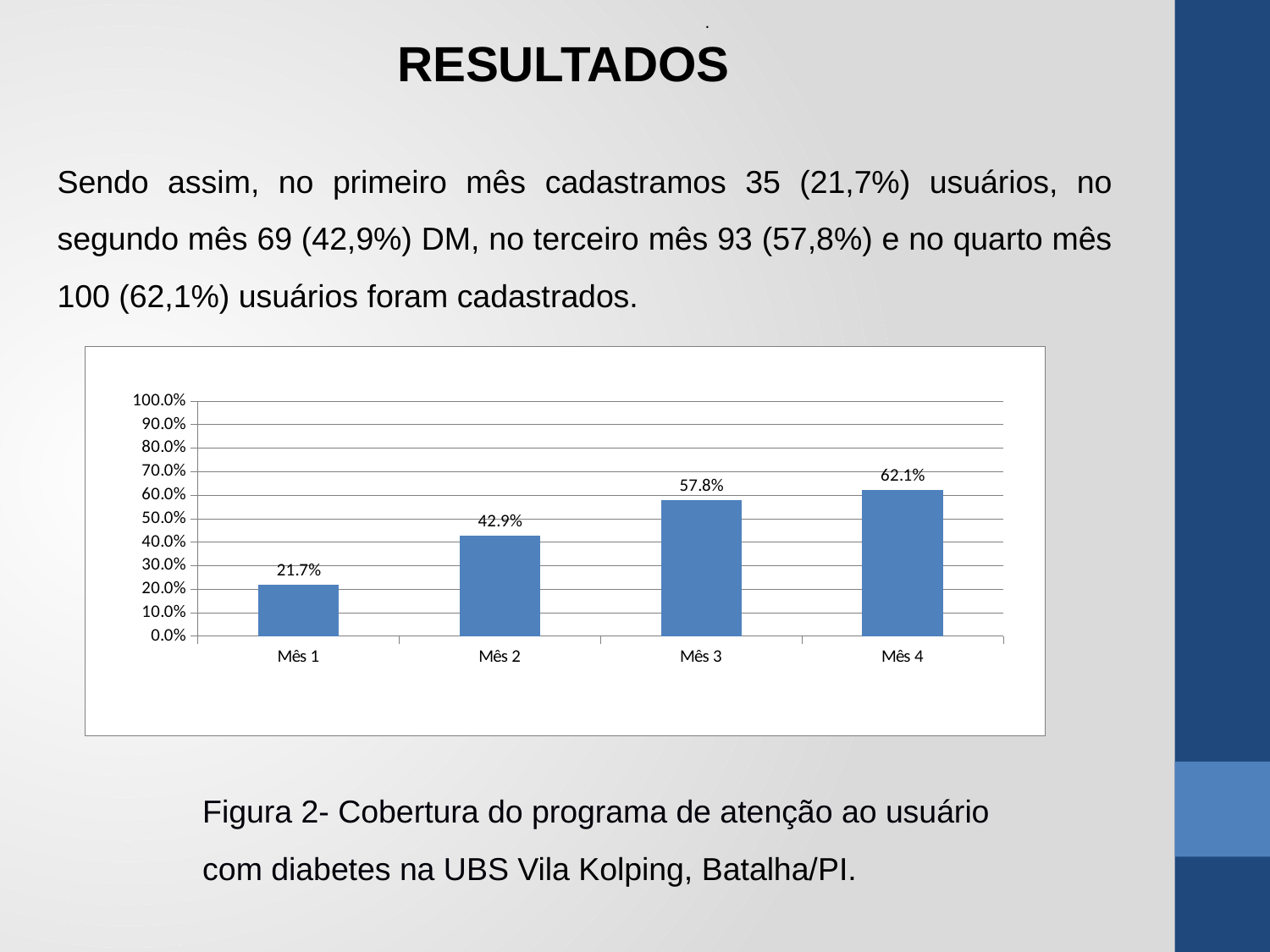
What is the value for Mês 4? 62.1% What is the difference between the values for Mês 2 and Mês 1? 21.2% Which is larger, the value for Mês 2 or the value for Mês 3? Mês 3 Which month has the highest value? Mês 4 Is the value for Mês 2 greater or less than 50.0%? less What is the difference between the values for Mês 4 and Mês 3? 4.3% Do the values rise or fall from Mês 1 to Mês 4? rise Which month has the lowest value? Mês 1 What is the value for Mês 3? 57.8% What is the value for Mês 1? 21.7% How many months are shown on the x axis? 4 What kind of chart is shown on the slide? bar chart